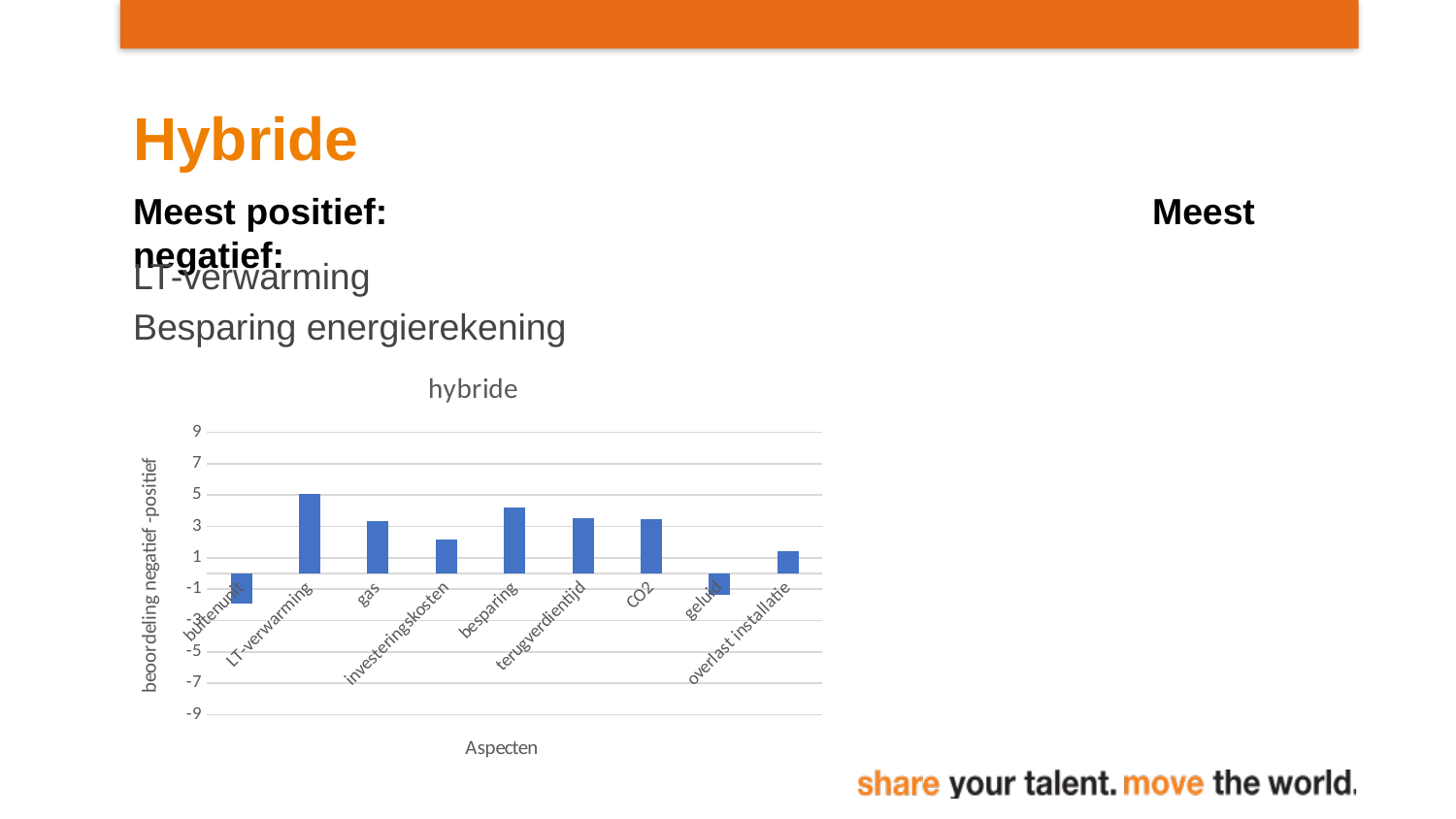
Is the value for besparing greater or less than 3? greater What kind of chart is shown on the slide? bar chart Is the value for investeringskosten greater or less than 3? less What is the label of the x axis? Aspecten What is the title of the chart? hybride How many categories have a negative value in the chart? 2 Which category has the highest value in the chart? LT-verwarming How many categories (aspecten) are plotted in the chart? 9 Is the value for buitenunit greater or less than 0? less Which is larger, the value for LT-verwarming or the value for gas? LT-verwarming